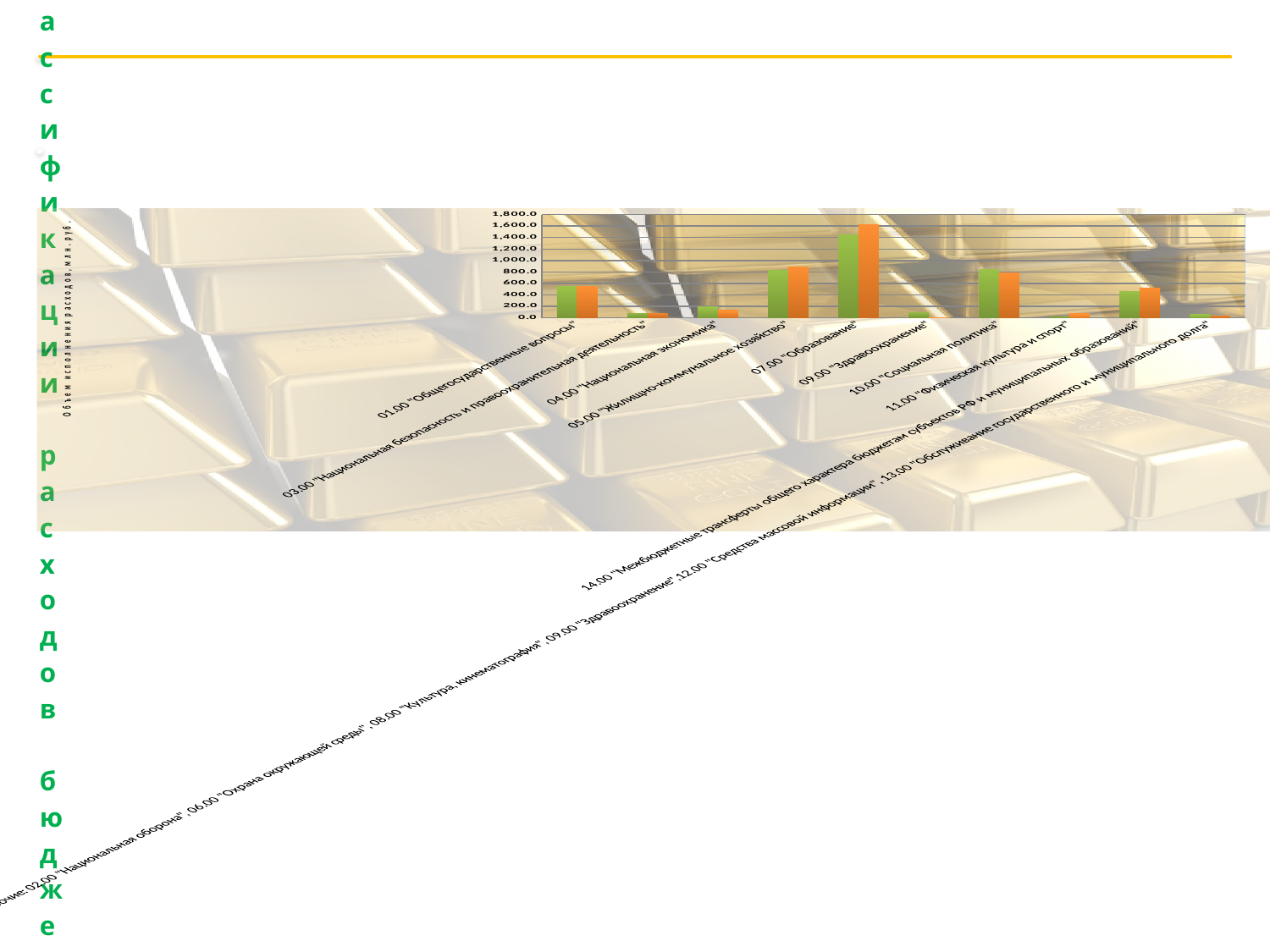
How many categories are shown along the x axis of the chart? 10 Is the green bar for 10.00 "Социальная политика" greater or less than 600.0? greater Is the orange bar for 07.00 "Образование" greater or less than 1,200.0? greater Is the orange bar for 05.00 "Жилищно-коммунальное хозяйство" greater or less than 600.0? greater How many data series (bars per category) are plotted in the chart? 2 Which has larger values, 07.00 "Образование" or 09.00 "Здравоохранение"? 07.00 "Образование" What kind of chart is shown on the slide? bar chart What is the title of the vertical axis of the chart? Объем исполнения расходов, млн. руб. Which category has the tallest bars in the chart? 07.00 "Образование" Which has a larger orange bar, 05.00 "Жилищно-коммунальное хозяйство" or 04.00 "Национальная экономика"? 05.00 "Жилищно-коммунальное хозяйство"